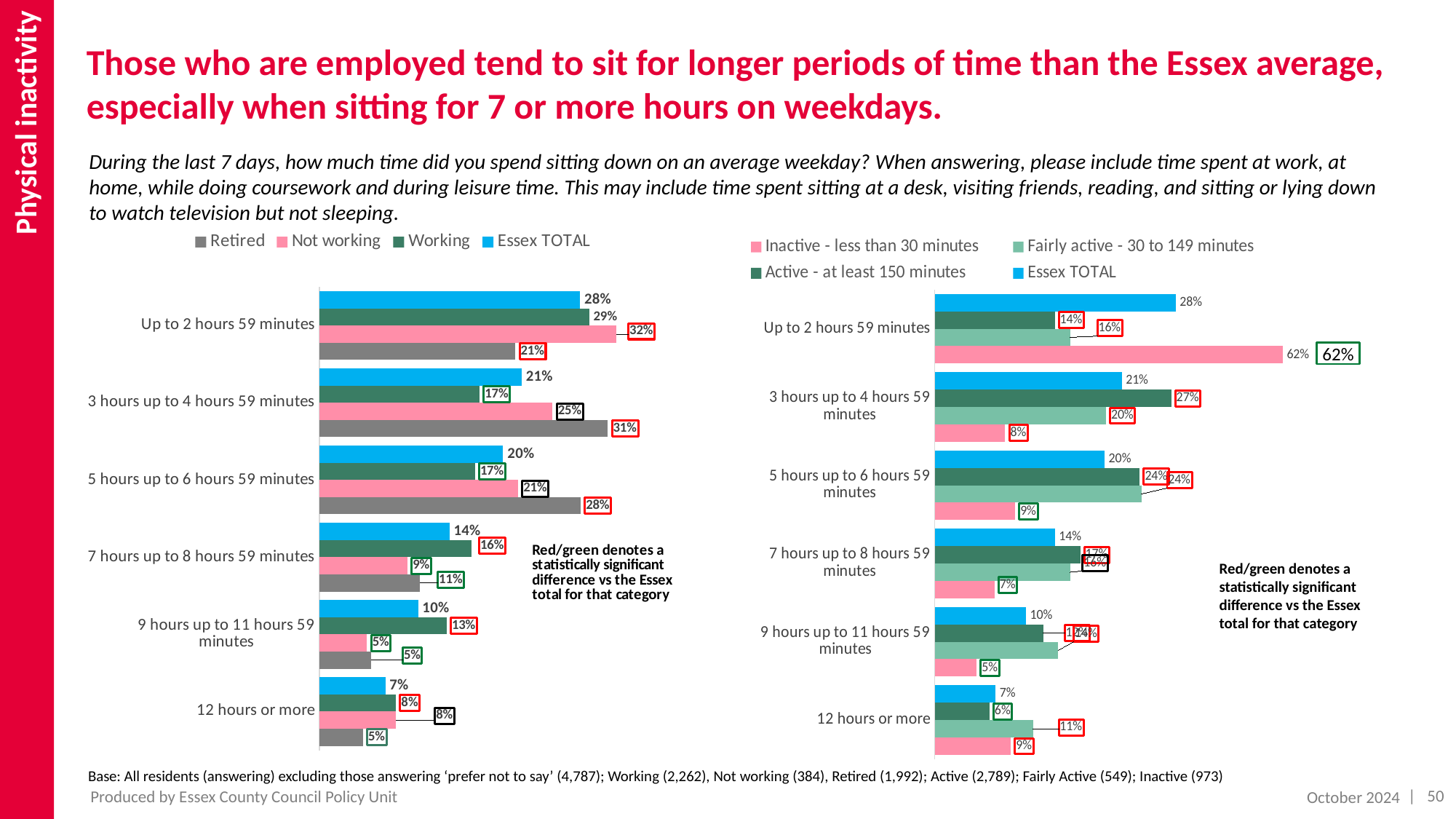
In the right chart (by activity level), what is the difference between the Inactive value and the Essex TOTAL value for 'Up to 2 hours 59 minutes'? 34 percentage points In the left chart (by employment status), what is the Essex TOTAL value for '7 hours up to 8 hours 59 minutes'? 14% In the right chart (by activity level), what is the value for 'Fairly active - 30 to 149 minutes' in the '12 hours or more' category? 11% How many sitting-time categories are shown in the left chart (by employment status)? 6 In the left chart (by employment status), what is the difference between the Retired and Working values for '5 hours up to 6 hours 59 minutes'? 11 percentage points How many series does the legend of the right chart (by activity level) list? 4 In the left chart (by employment status), is the Working value or the Not working value larger for '9 hours up to 11 hours 59 minutes'? Working In the right chart (by activity level), which series has the lowest value in the '3 hours up to 4 hours 59 minutes' category? Inactive - less than 30 minutes What type of chart is the left chart (by employment status)? Bar chart In the right chart (by activity level), what is the value for 'Inactive - less than 30 minutes' in the 'Up to 2 hours 59 minutes' category? 62% In the left chart (by employment status), which series has the highest value in the 'Up to 2 hours 59 minutes' category? Not working In the left chart (by employment status), what is the value for Retired in the '3 hours up to 4 hours 59 minutes' category? 31%